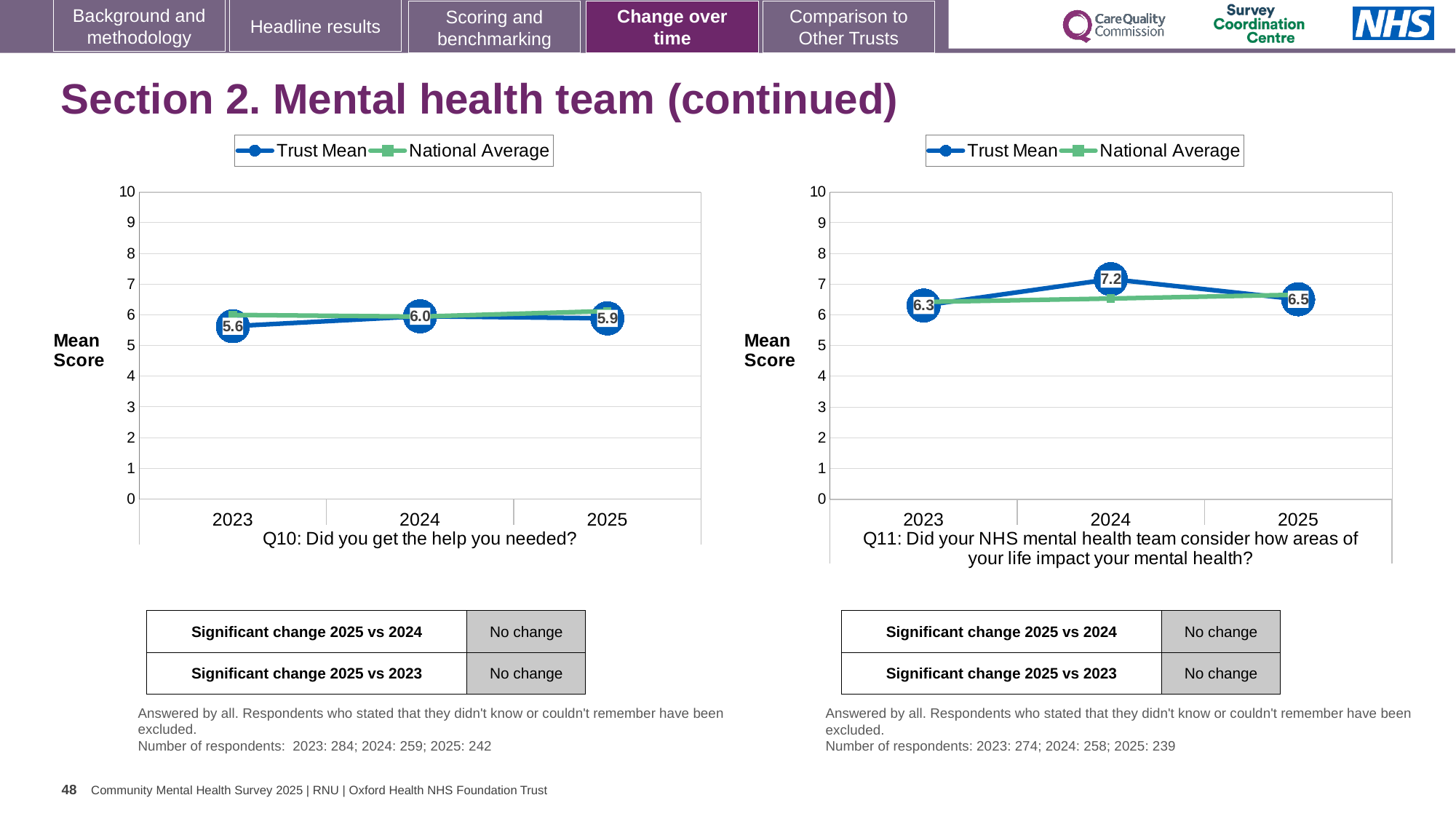
On the Q11 chart (right), what is the Trust Mean for 2024? 7.2 On the Q10 chart (left), is the Trust Mean higher in 2024 or 2025? 2024 How many series does the legend of the Q11 chart (right) list? 2 On the Q10 chart (left), what is the Trust Mean for 2024? 6.0 On the Q11 chart (right), what is the difference between the Trust Mean for 2024 and 2023? 0.9 On the Q11 chart (right), which year has the highest Trust Mean? 2024 What type of chart is used for Q10 (left)? Line chart On the Q10 chart (left), what is the Trust Mean for 2023? 5.6 On the Q10 chart (left), which year has the lowest Trust Mean? 2023 On the Q11 chart (right), what is the Trust Mean for 2025? 6.5 On the Q11 chart (right), is the National Average for 2024 greater or less than 7? less How many years are shown on the x axis of the Q10 chart (left)? 3